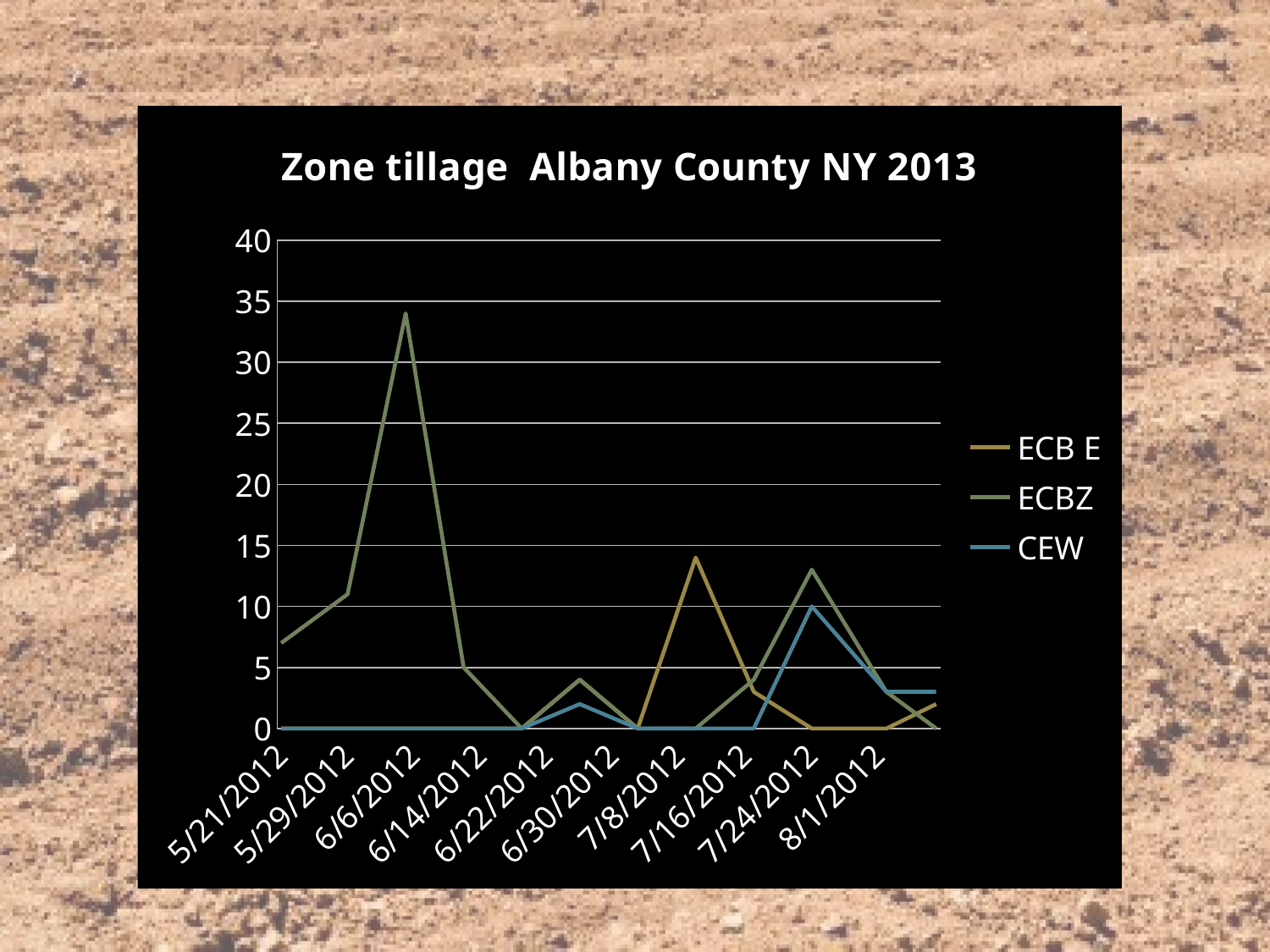
How many series does the legend list? 3 What kind of chart is shown on the slide? line chart Is the value for ECB E on 7/8/2012 greater or less than 10? greater What is the title of the chart? Zone tillage Albany County NY 2013 Which series reaches the highest value on the chart? ECBZ Is the value for CEW on 7/24/2012 greater or less than 5? greater Does the ECBZ line rise or fall between 6/6/2012 and 6/14/2012? fall What is the value for CEW on 5/21/2012? 0 Which series are listed in the legend? ECB E, ECBZ, CEW On 7/24/2012, which series has the larger value, ECBZ or CEW? ECBZ Is the value for ECBZ on 6/6/2012 greater or less than 30? greater